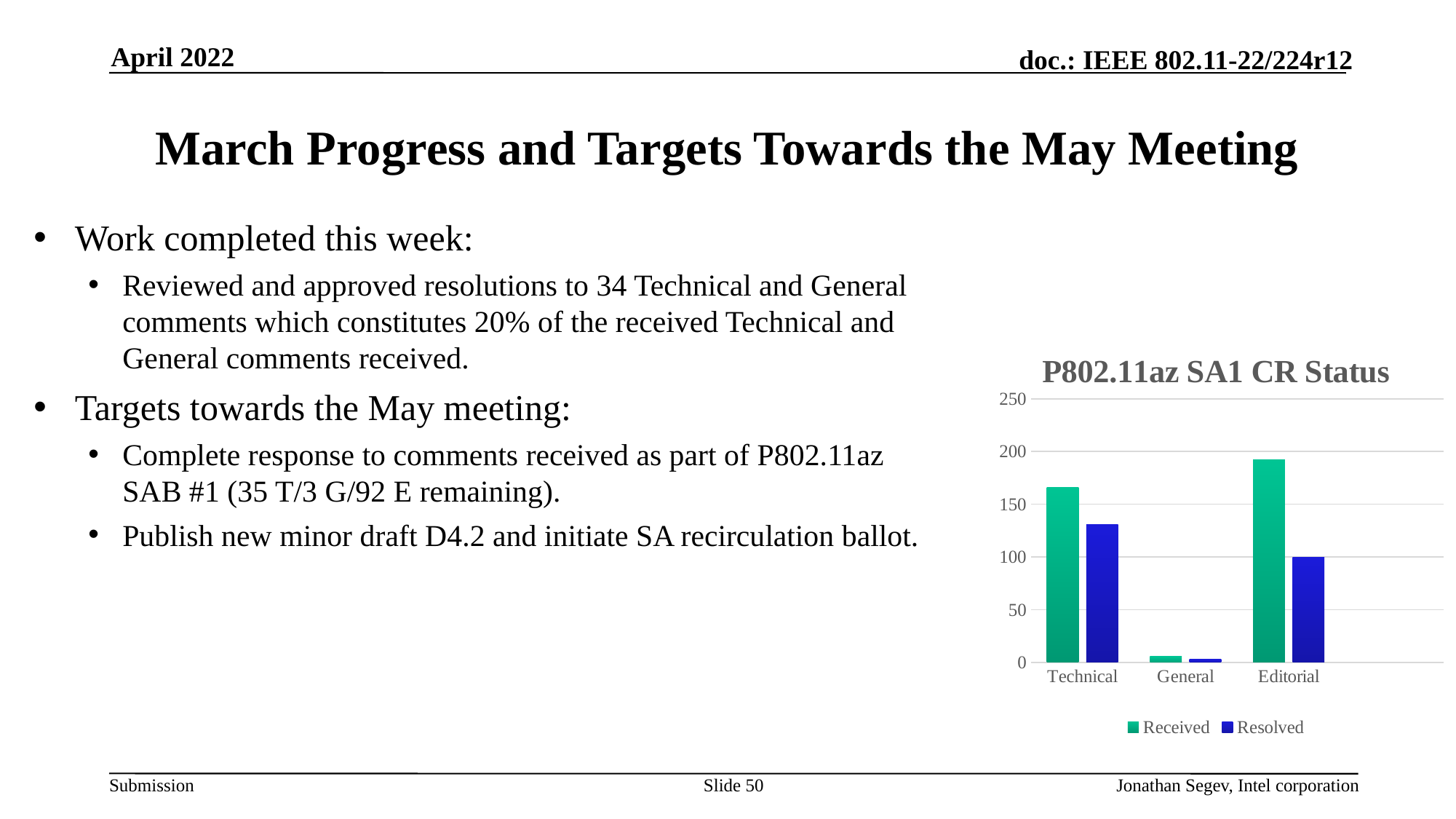
Which category has the lowest Received value? General What kind of chart is shown on the slide? bar chart What are the two series named in the chart's legend? Received and Resolved Is the Received value for Technical greater or less than 150? greater For the Technical category, which is larger: Received or Resolved? Received Is the Received value for Editorial greater or less than 200? less Which category has the highest Received value? Editorial Is the Resolved value for Technical greater or less than 150? less What is the title of the chart on the slide? P802.11az SA1 CR Status How many categories are shown on the x axis of the chart? 3 How many series does the chart's legend list? 2 Which category has the highest Resolved value? Technical